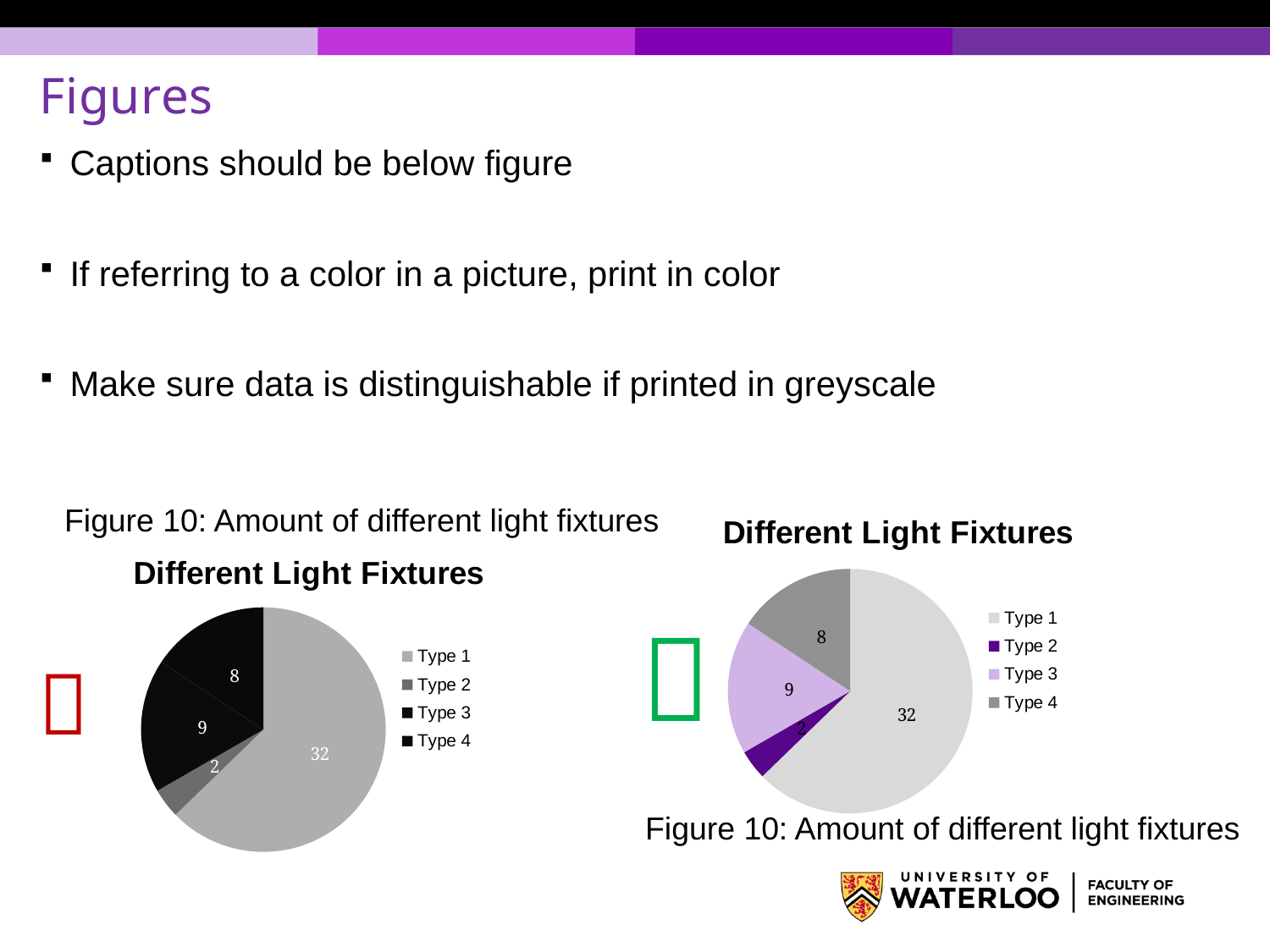
In the right pie chart, what is the difference between the values for Type 1 and Type 4? 24 What kind of chart is shown on the left side of the slide? Pie chart In the left pie chart, which is larger, the value for Type 3 or the value for Type 4? Type 3 In the right pie chart, which type has the smallest slice? Type 2 In the right pie chart, what is the value for Type 3? 9 In the left pie chart, what is the value for Type 4? 8 How many slices does the right pie chart have? 4 In the left pie chart, which type has the largest slice? Type 1 What is the total of all slices in the left pie chart? 51 In the right pie chart, what is the value for Type 2? 2 In the left pie chart, what is the value for Type 1? 32 What is the title of the right pie chart? Different Light Fixtures